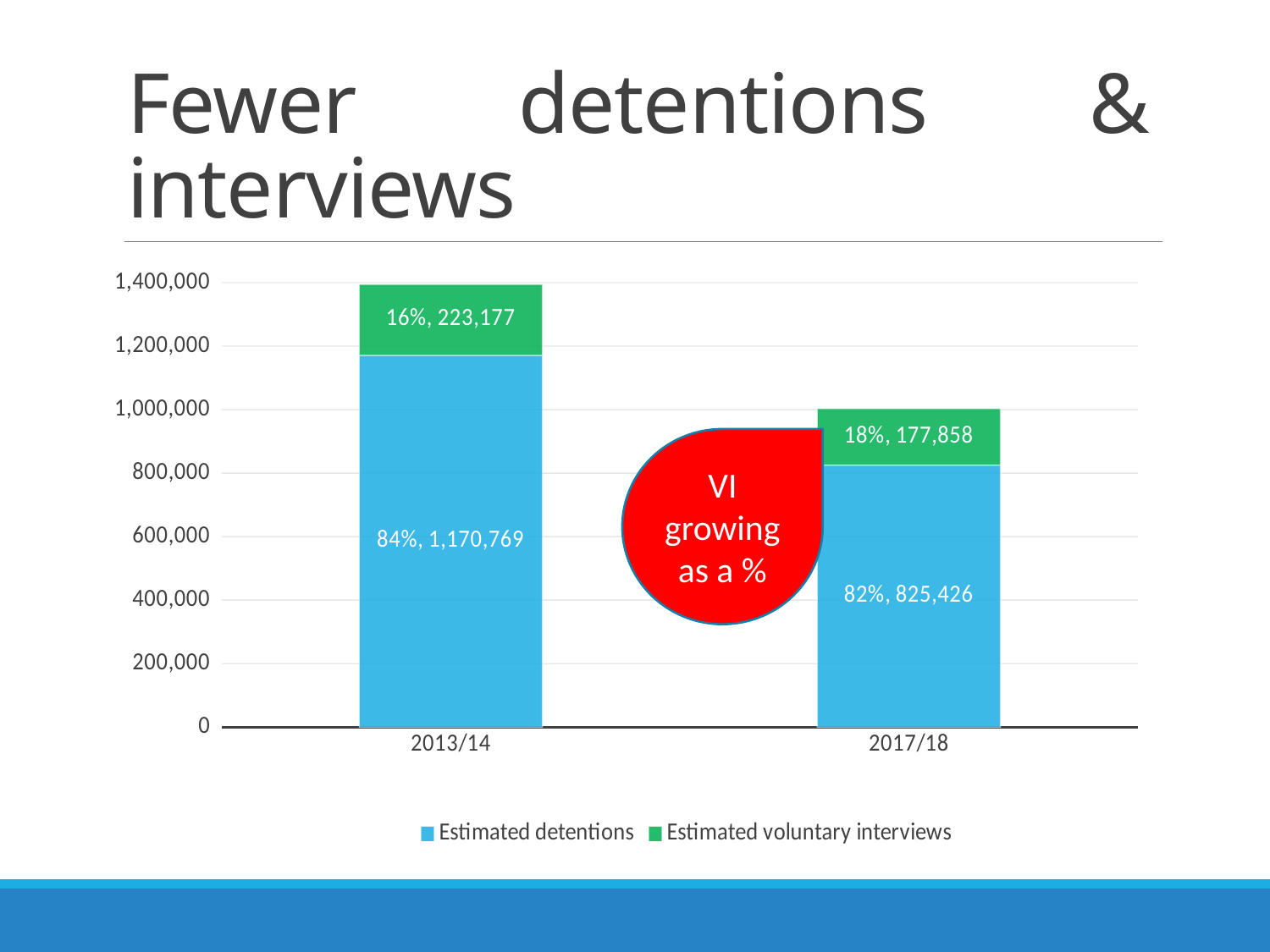
What is the estimated number of voluntary interviews in 2017/18? 177,858 How many series does the legend list? 2 What percentage of the 2017/18 total do estimated detentions make up? 82% Which year has the higher estimated number of detentions? 2013/14 What is the difference in estimated detentions between 2013/14 and 2017/18? 345,343 Which year has the lower estimated number of voluntary interviews? 2017/18 What is the difference in estimated voluntary interviews between 2013/14 and 2017/18? 45,319 What is the estimated number of detentions in 2013/14? 1,170,769 What is the total of the stacked bar for 2017/18? 1,003,284 What kind of chart is shown on the slide? Stacked bar chart What is the total of the stacked bar for 2013/14? 1,393,946 What percentage of the 2013/14 total do estimated voluntary interviews make up? 16%